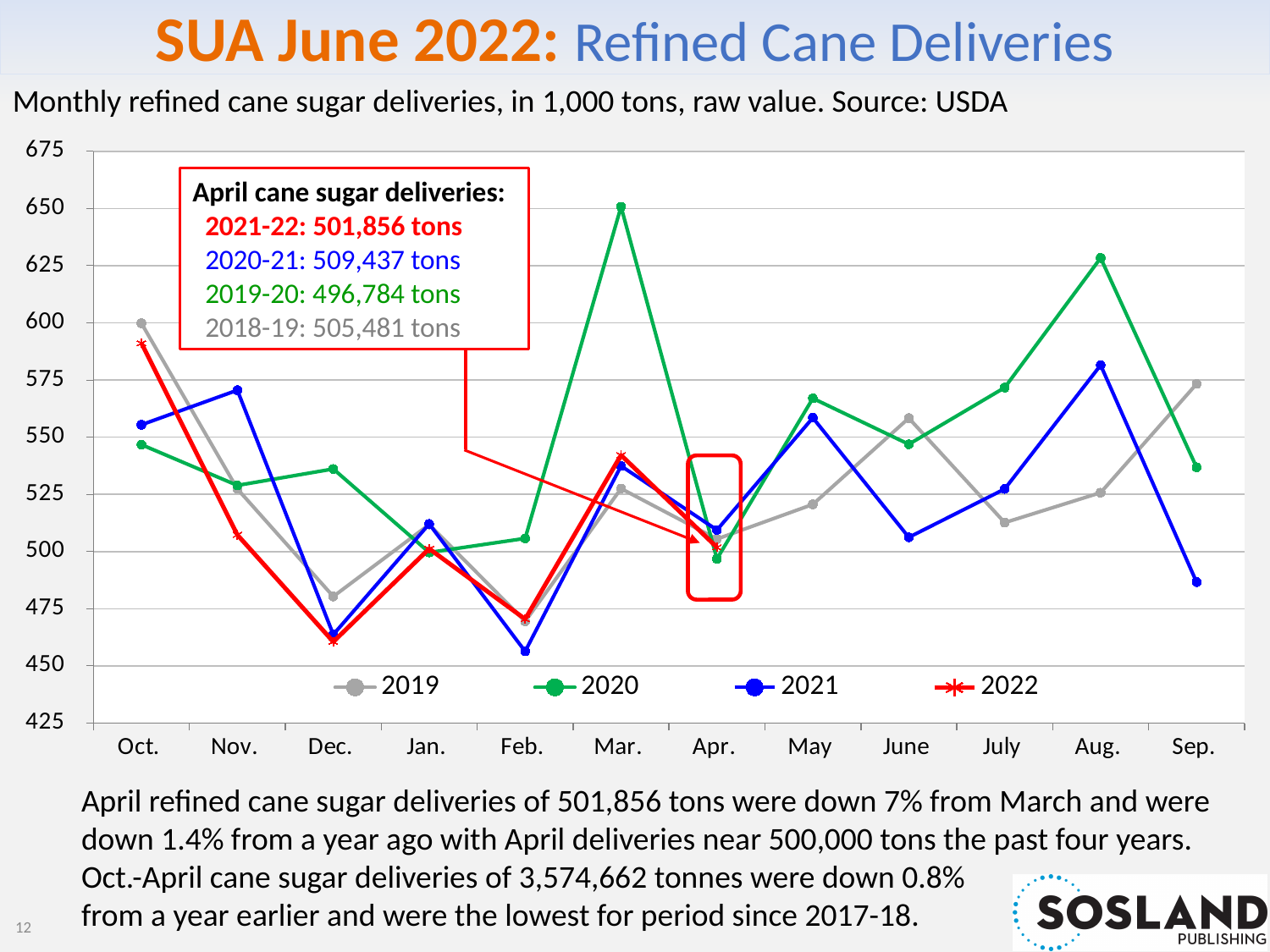
According to the annotation box, what were April cane sugar deliveries in 2019-20? 496,784 tons How many months are shown along the x axis of the chart? 12 Is the 2020 series value for March greater or less than 625? greater According to the annotation box, what were April cane sugar deliveries in 2021-22? 501,856 tons Which series has the highest value in March? 2020 What kind of chart is shown on the slide? line chart In August, which series is higher, 2020 or 2021? 2020 How many series does the chart legend list? 4 According to the annotation box, what were April cane sugar deliveries in 2020-21? 509,437 tons According to the annotation box, what were April cane sugar deliveries in 2018-19? 505,481 tons Of the four April values listed in the annotation box, which year had the highest deliveries? 2020-21 By how much were April cane sugar deliveries in 2020-21 higher than in 2021-22, according to the annotation box? 7,581 tons